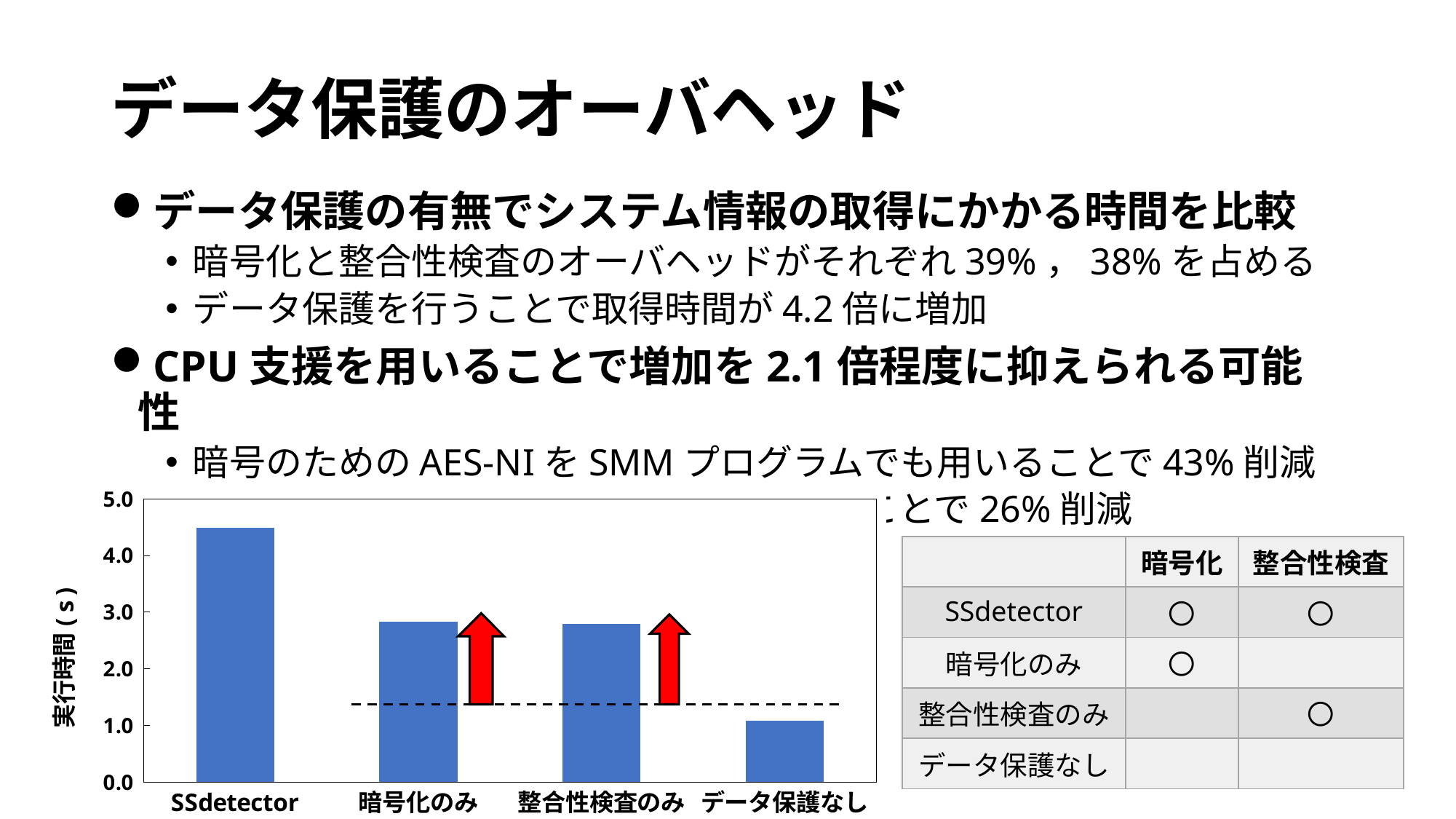
What is the highest tick value shown on the y axis of the chart? 5.0 Which is larger, the value for 整合性検査のみ or the value for データ保護なし? 整合性検査のみ Which category has the highest execution time in the chart? SSdetector What kind of chart is shown on the slide? bar chart How many categories are plotted on the x axis of the chart? 4 Is the value for 整合性検査のみ greater or less than 2.0? greater Is the value for SSdetector greater or less than 4.0? greater What is the label of the y axis of the chart? 実行時間 ( s ) Is the value for 暗号化のみ greater or less than 3.0? less Which is larger, the value for SSdetector or the value for 暗号化のみ? SSdetector Which category has the lowest execution time in the chart? データ保護なし